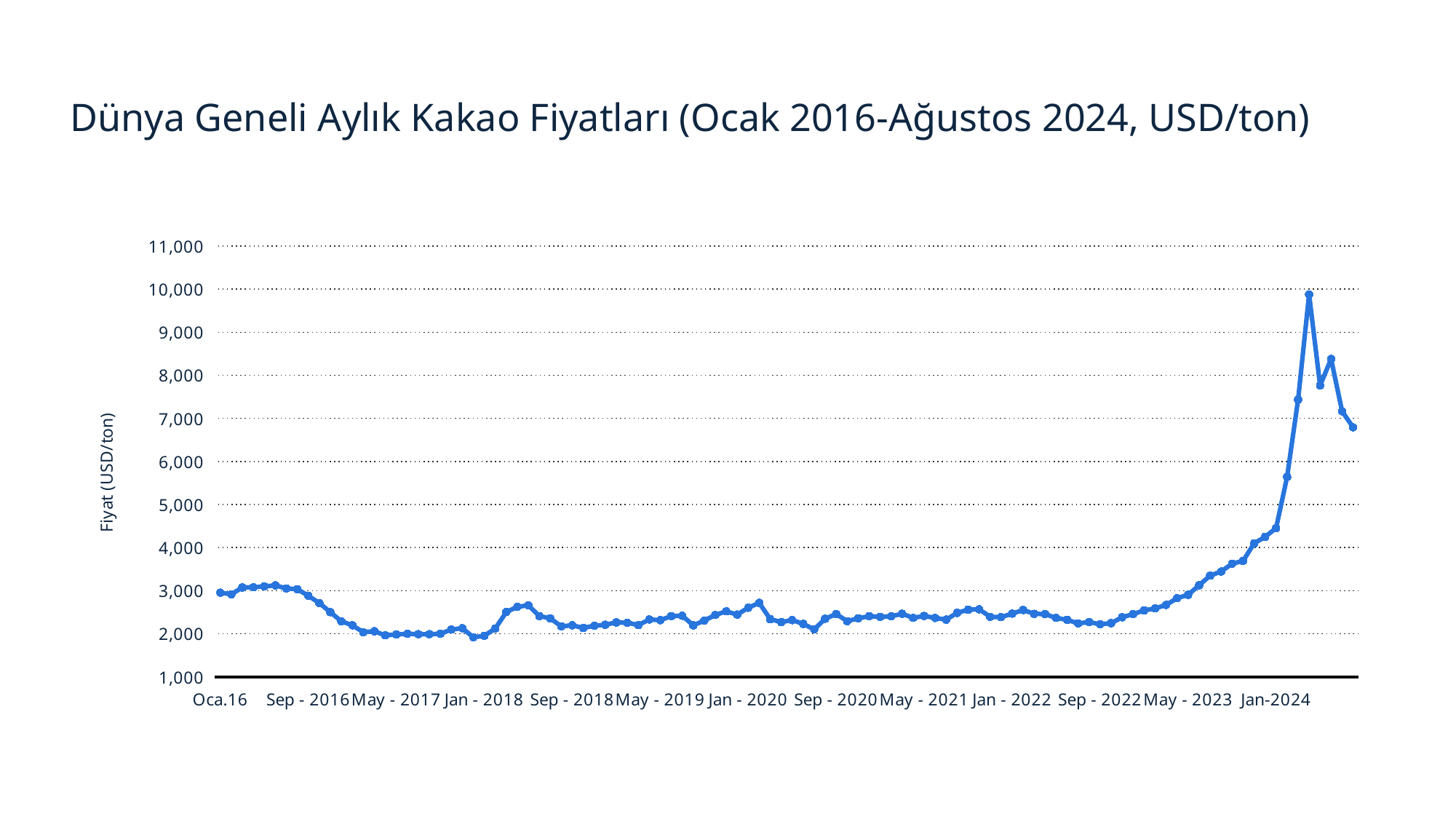
Is the value at Jan - 2018 greater or less than 3,000? less What kind of chart is shown on the slide? line chart Does the line rise or fall between Sep - 2022 and Jan-2024? rise Does the line rise or fall between Oca.16 and May - 2017? fall How many lines (data series) are plotted on the chart? 1 Is the highest point on the line greater or less than 10,000? less What is the label of the vertical axis? Fiyat (USD/ton) Is the value at Sep - 2022 greater or less than 3,000? less What is the title of the chart? Dünya Geneli Aylık Kakao Fiyatları (Ocak 2016-Ağustos 2024, USD/ton)